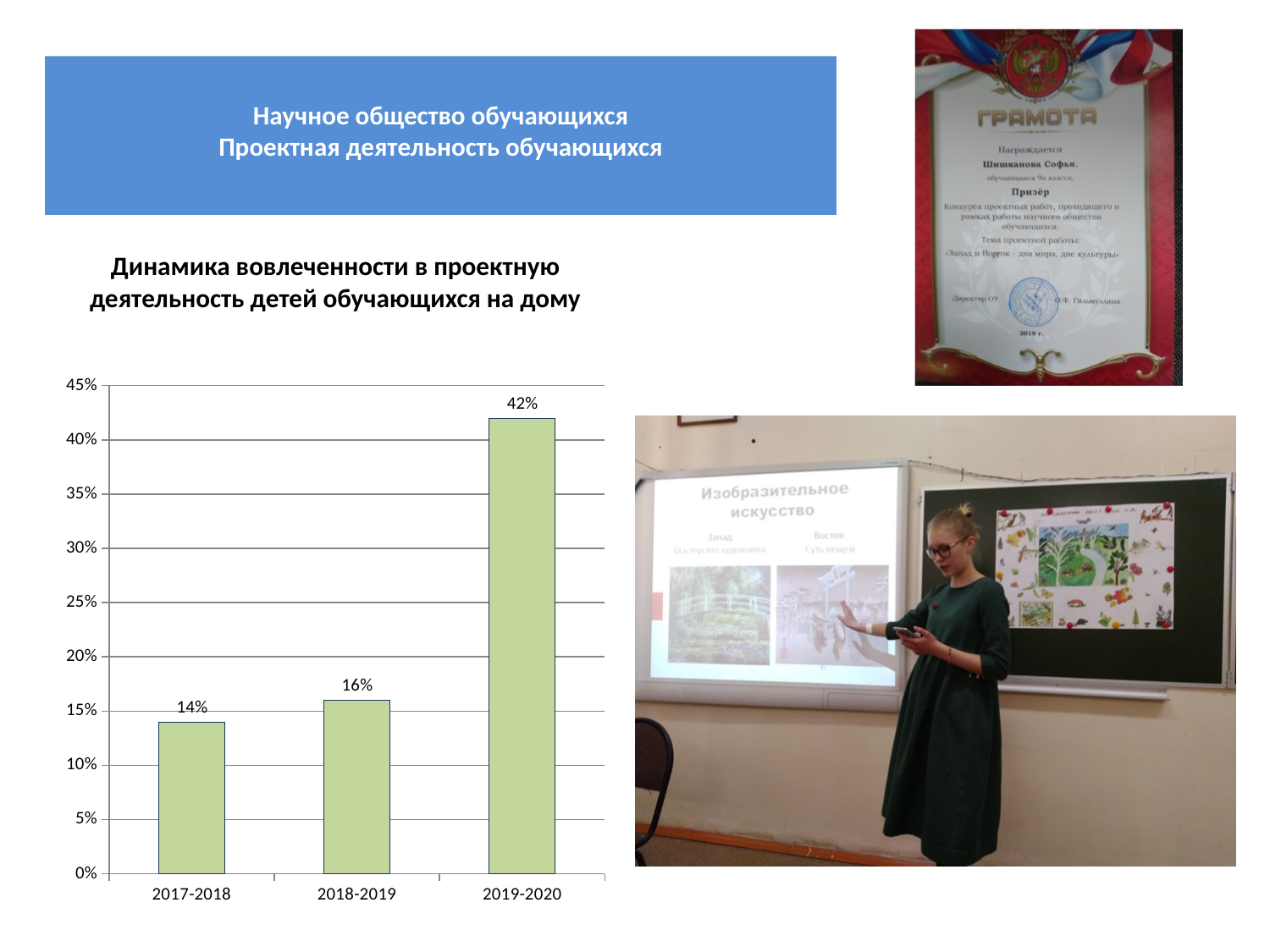
What is the value for 2019-2020? 42% What is the difference between the values for 2018-2019 and 2017-2018? 2% Is the value for 2019-2020 greater or less than 40%? greater What kind of chart is shown on the slide? bar chart Which is larger, the value for 2019-2020 or the value for 2017-2018? 2019-2020 What is the difference between the values for 2019-2020 and 2018-2019? 26% Do the values rise or fall from 2017-2018 to 2019-2020? rise Which period has the highest value? 2019-2020 Which period has the lowest value? 2017-2018 How many periods are shown on the x axis? 3 What is the value for 2017-2018? 14% What is the value for 2018-2019? 16%